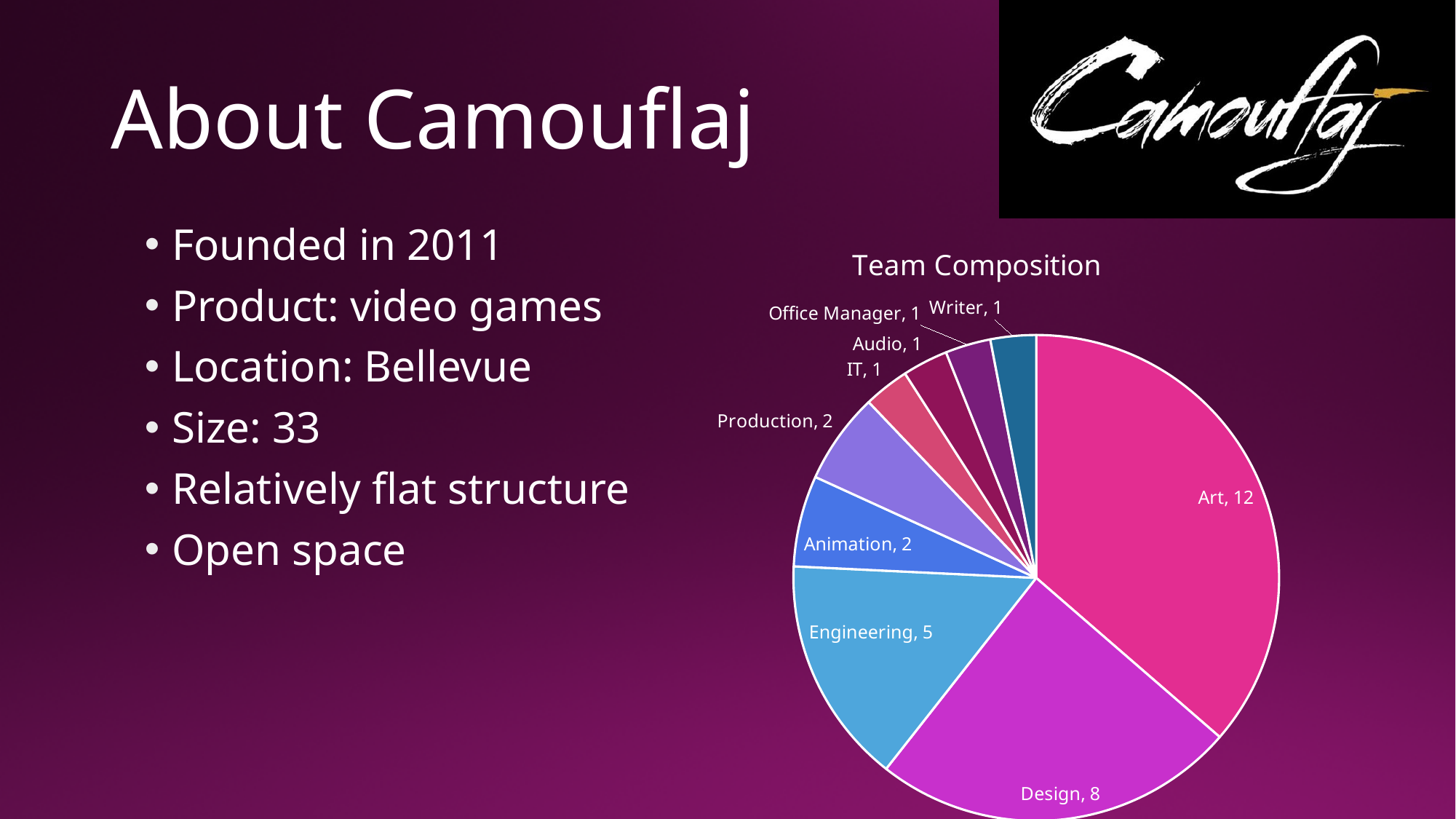
How many categories are shown in the Team Composition pie chart? 9 How many categories in the Team Composition chart have a value of 1? 4 What is the difference between the Art and Design values in the Team Composition chart? 4 What type of chart is shown on the slide? Pie chart What is the value for Production in the Team Composition chart? 2 What is the total of all slices in the Team Composition chart? 33 What is the title of the chart? Team Composition Which is larger in the Team Composition chart, Engineering or Animation? Engineering Which category has the largest slice in the Team Composition chart? Art What is the value for Design in the Team Composition chart? 8 What is the value for Engineering in the Team Composition chart? 5 How many people are in Art according to the Team Composition chart? 12